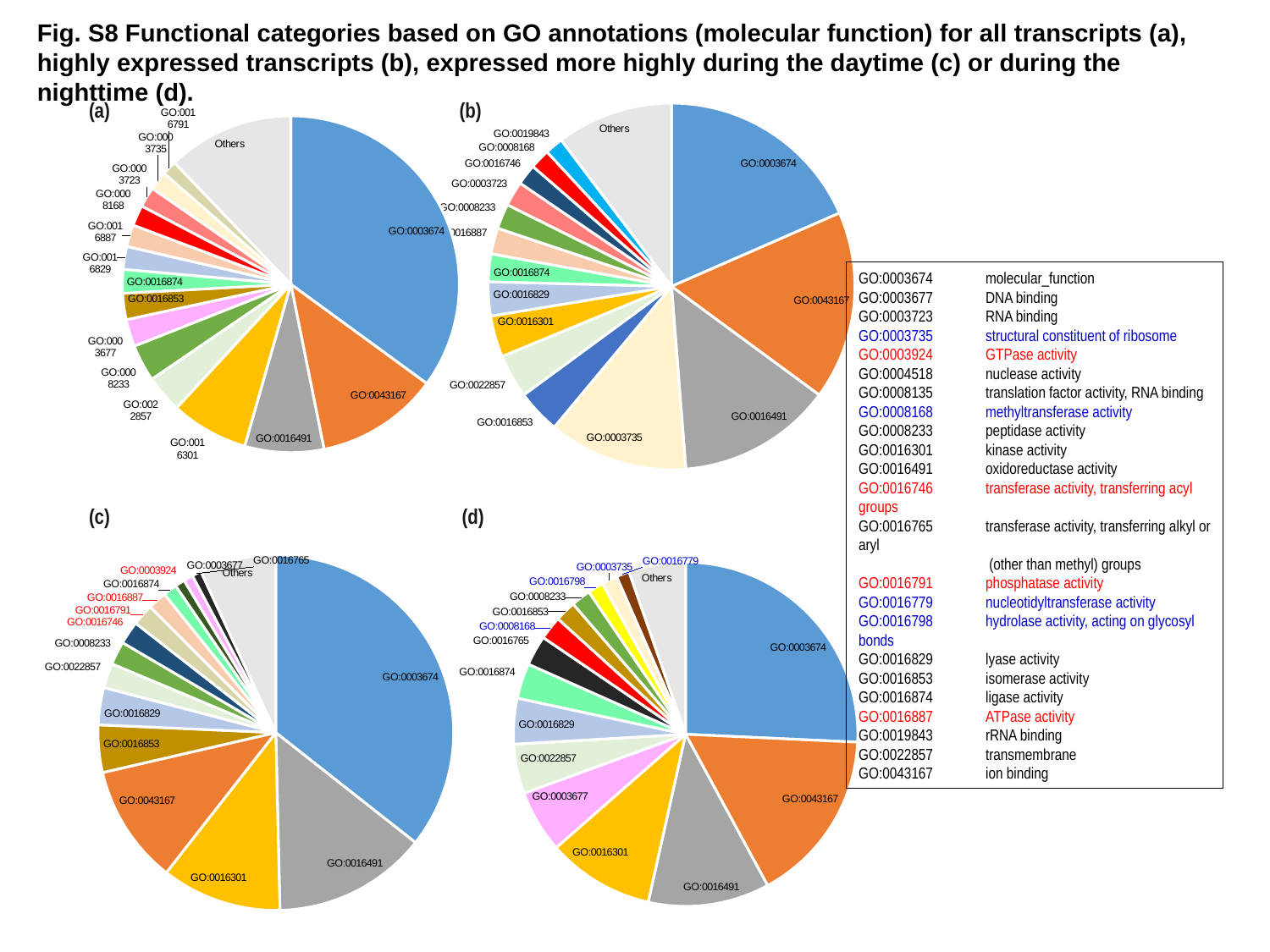
According to the legend table on the slide, what does GO:0016491 stand for? oxidoreductase activity In chart (b), which slice is larger, GO:0043167 or GO:0016829? GO:0043167 In chart (b), which category has the largest slice? GO:0003674 In chart (c), which slice is larger, GO:0016491 or GO:0016853? GO:0016491 What kind of chart is chart (a)? pie chart How many pie charts are shown on the slide? 4 In chart (a), which slice is larger, GO:0003674 or GO:0016491? GO:0003674 According to the legend table on the slide, what does GO:0043167 stand for? ion binding In chart (c), which category has the largest slice? GO:0003674 In chart (a), which category has the largest slice? GO:0003674